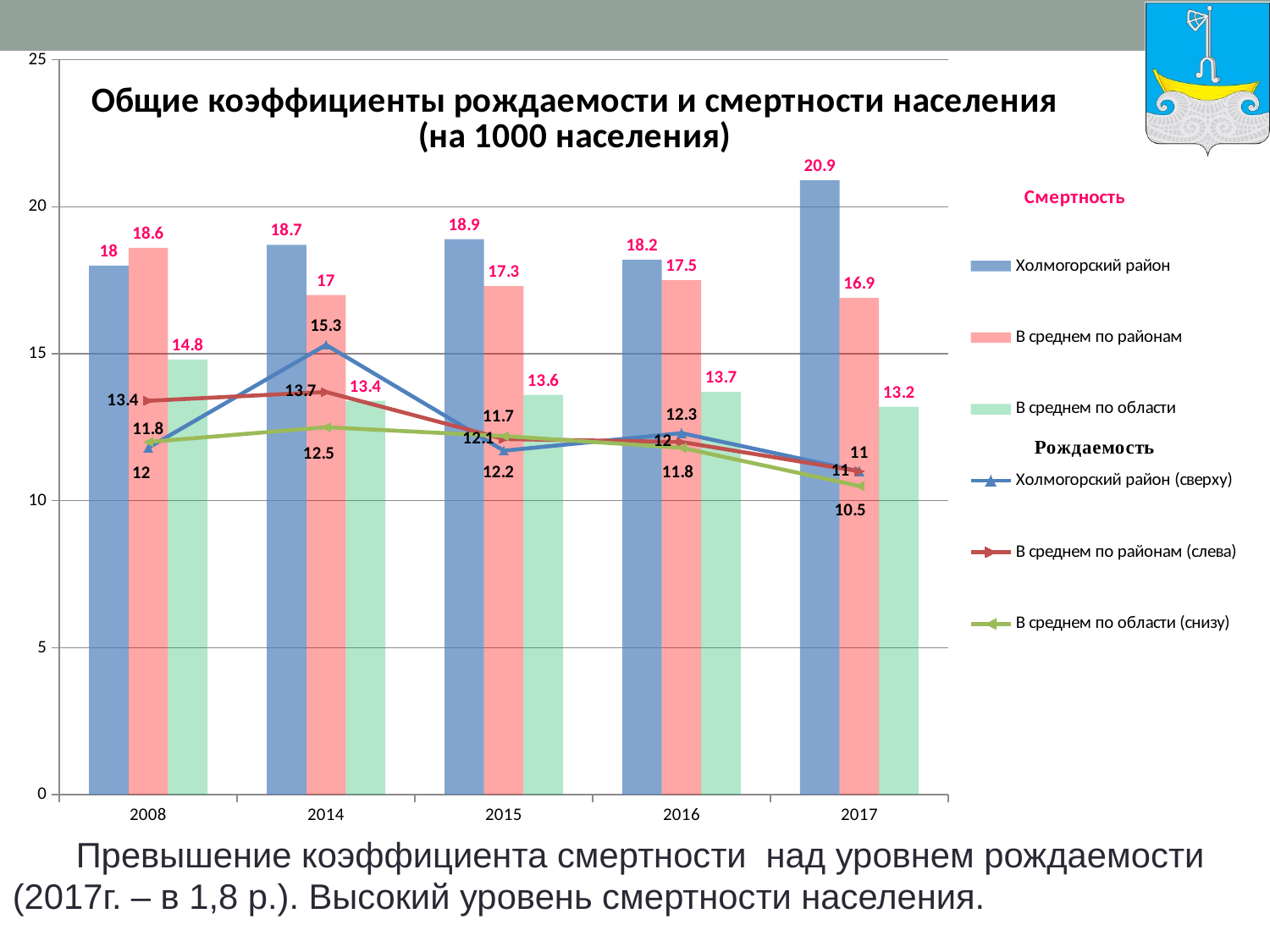
In which year is the Холмогорский район mortality bar the highest? 2017 How many years are shown on the x axis? 5 What is the value of the 'В среднем по области' bar in 2008? 14.8 What is the birth rate (line) for Холмогорский район in 2014? 15.3 What is the difference between the Холмогорский район mortality bar and the 'В среднем по районам' bar in 2017? 4 Does the 'В среднем по районам' mortality bar rise or fall from 2016 to 2017? fall Which is larger in 2008: the Холмогорский район bar or the 'В среднем по районам' bar? В среднем по районам Is the Холмогорский район mortality bar for 2017 greater or less than 20? greater What kind of chart is this? Combined bar and line chart What is the mortality rate (bar) for Холмогорский район in 2017? 20.9 How many series does the legend list? 6 In which year is the 'В среднем по области' birth-rate line at its lowest? 2017